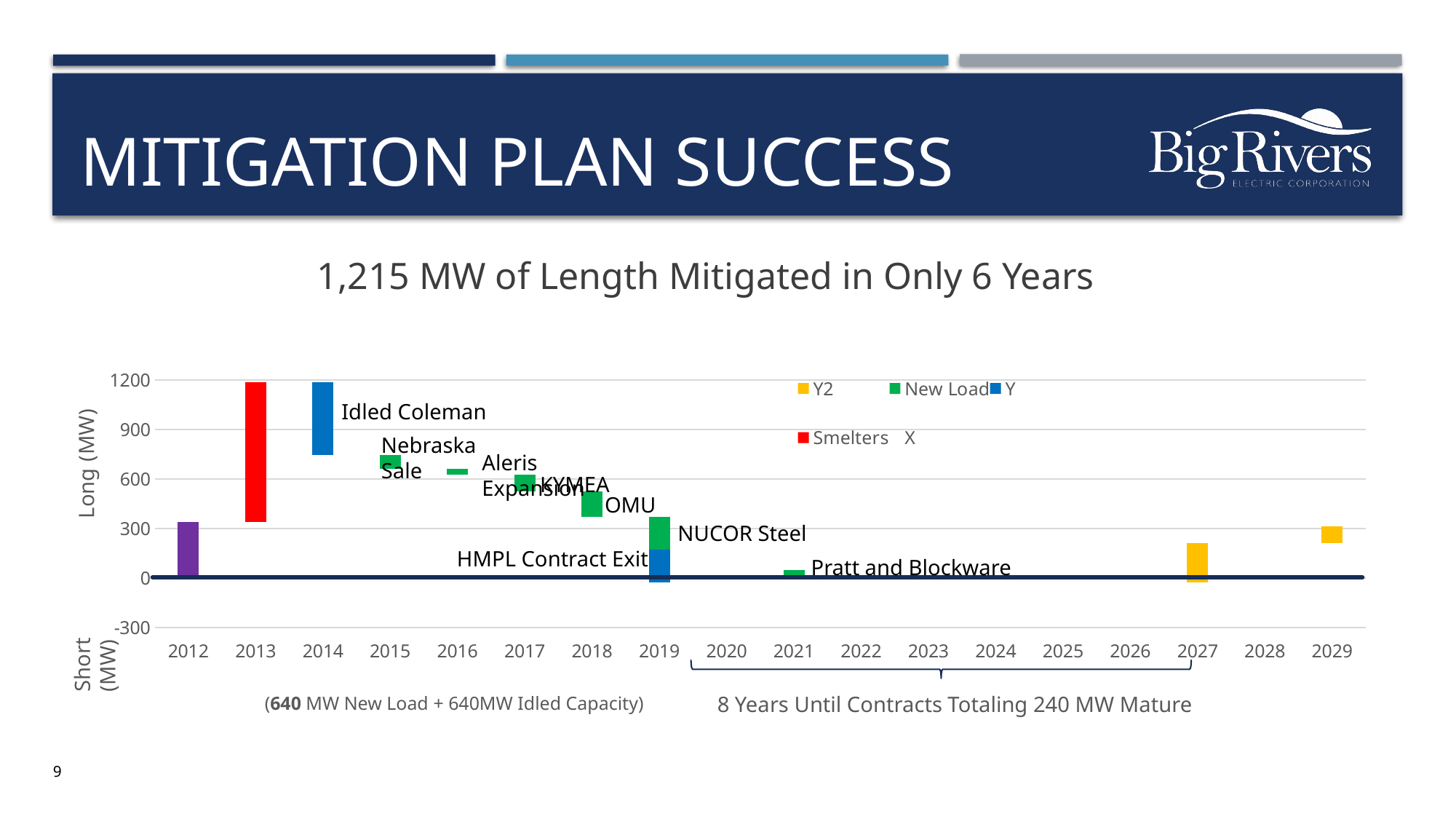
Which year's bar is annotated "Pratt and Blockware"? 2021 Is the top of the red bar for 2013 greater or less than 900 MW? greater Is the bottom of the blue bar for 2014 greater or less than 600 MW? greater Which bar is taller, the red bar for 2013 or the purple bar for 2012? 2013 How many series does the chart legend list? 5 From 2014 to 2021, do the bars generally rise or fall along the x axis? fall Which year has the tallest bar in the chart? 2013 Is the top of the purple bar for 2012 greater or less than 300 MW? greater Which year's bar is annotated "Idled Coleman"? 2014 How many years are shown along the x axis of the chart? 18 What kind of chart is shown on the slide? bar chart